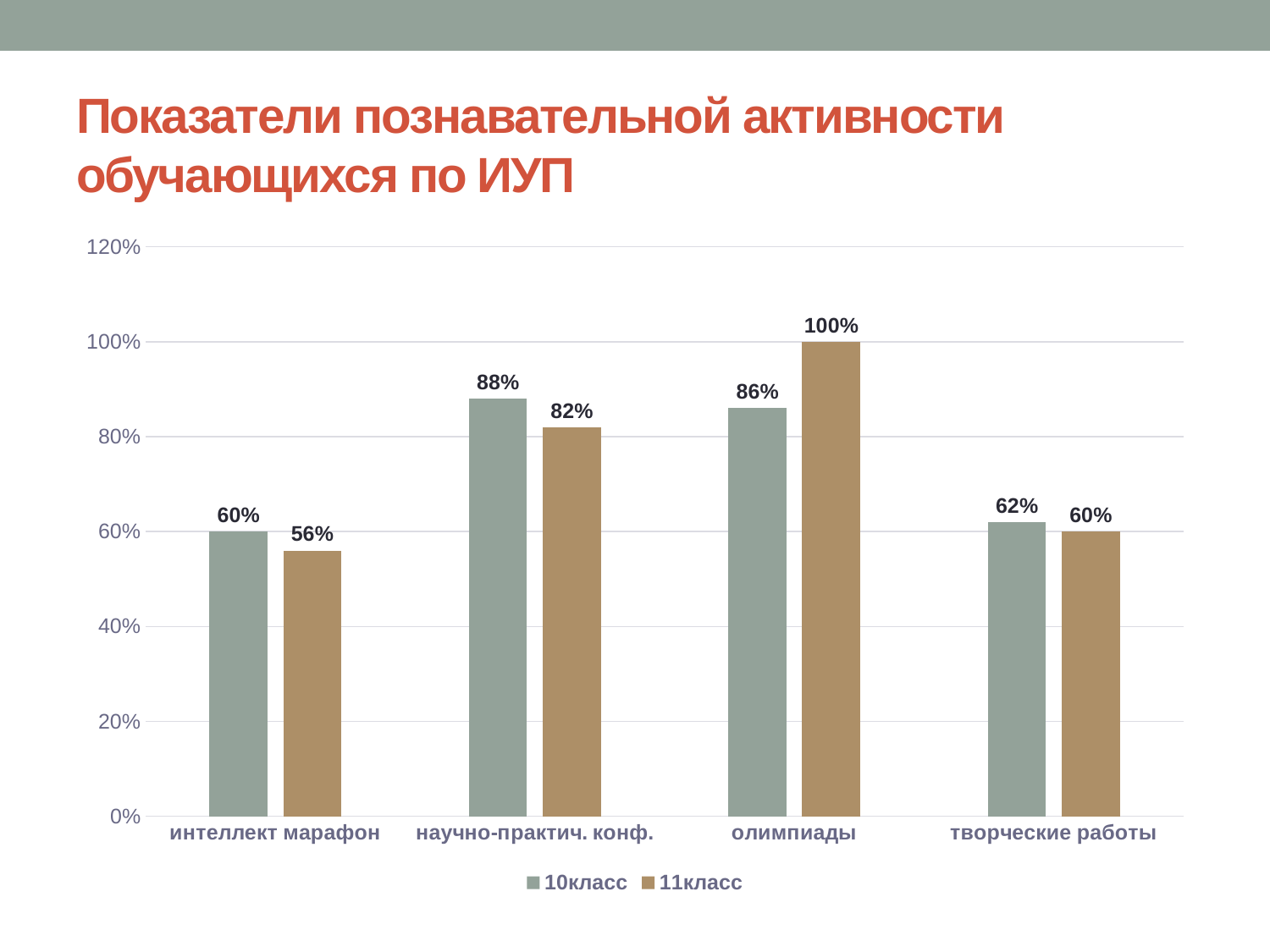
Which is larger in the научно-практич. конф. category: the 10класс value or the 11класс value? 10класс What is the value for 10класс in the творческие работы category? 62% What is the difference between the 11класс and 10класс values in the олимпиады category? 14% What is the value for 11класс in the научно-практич. конф. category? 82% What kind of chart is shown on the slide? bar chart Which category has the highest value for 11класс? олимпиады What is the value for 11класс in the интеллект марафон category? 56% How many categories are shown on the x axis? 4 How many series does the legend list? 2 What is the value for 10класс in the олимпиады category? 86% Which category has the lowest value for 10класс? интеллект марафон What are the two series listed in the legend? 10класс and 11класс